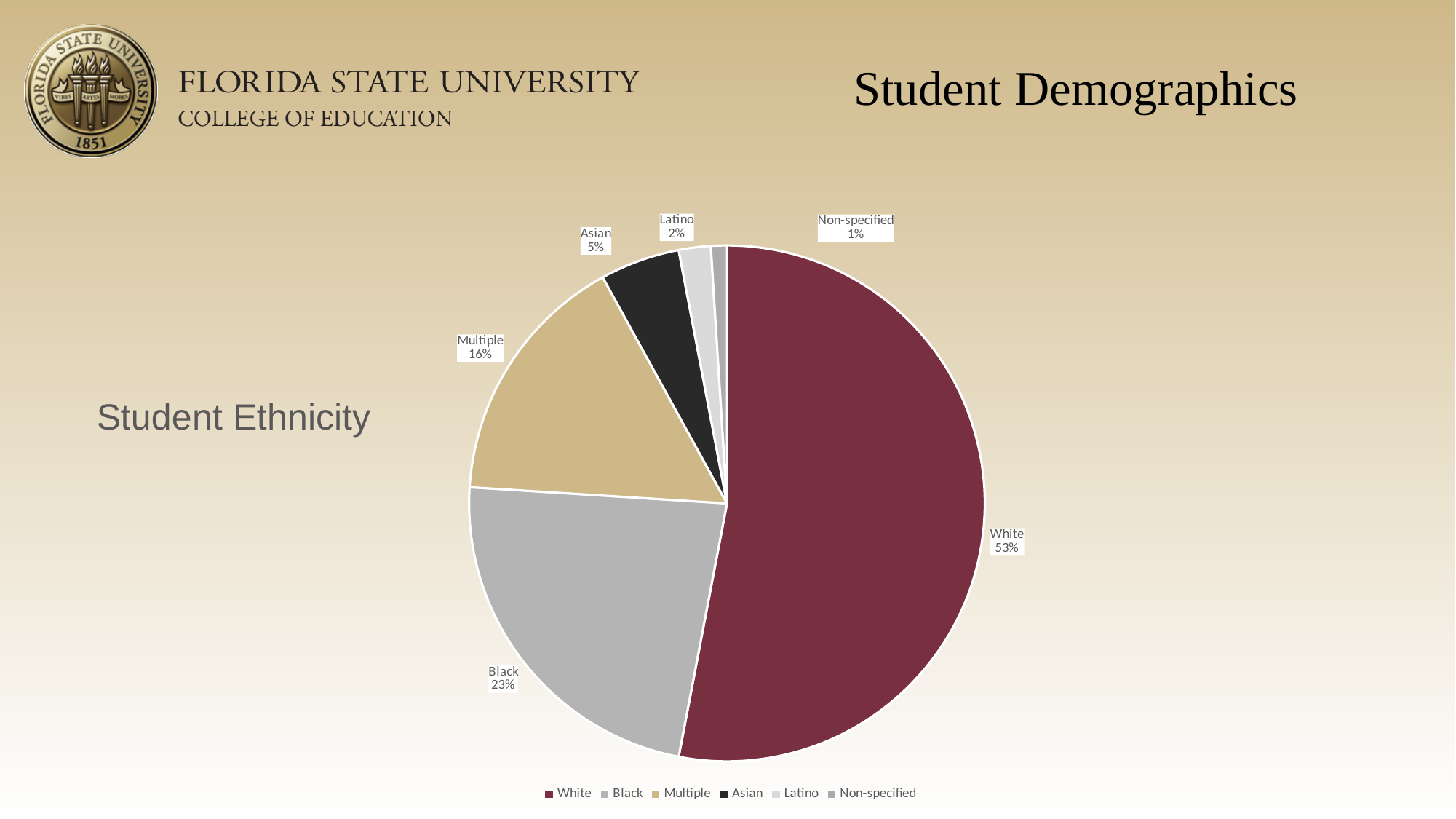
Which ethnicity has the smallest share of students? Non-specified What share of students is Multiple? 16% What share of students is Latino? 2% What share of students is Asian? 5% What is the difference in percentage points between the White and Black shares? 30 Which is larger, the Multiple share or the Asian share? Multiple Which ethnicity has the largest share of students? White What type of chart is shown on the slide? pie chart How many ethnicity categories are shown in the pie chart? 6 What colour is the White slice in the pie chart? dark red What share of students is Black? 23% What share of students is White? 53%